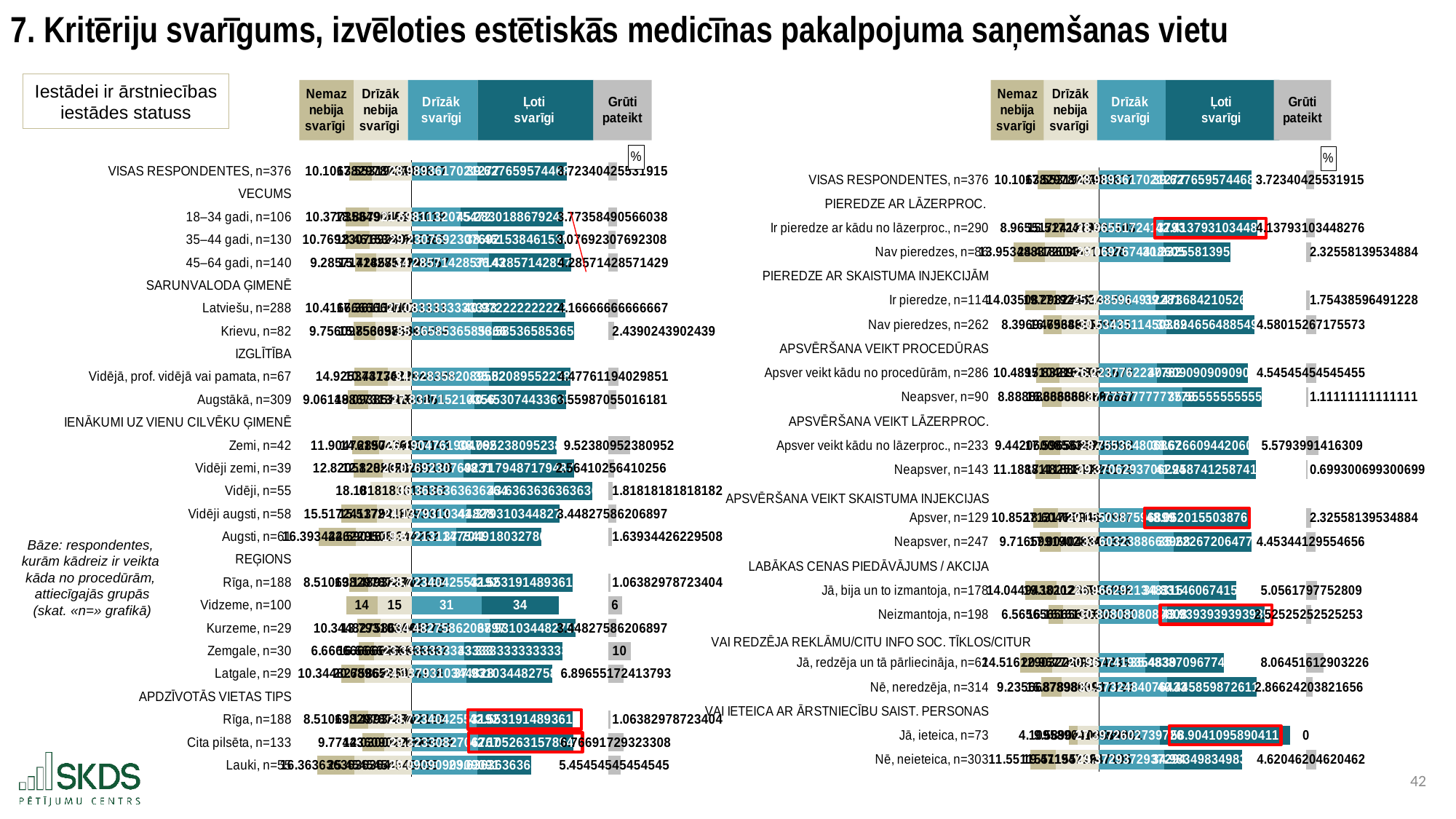
In the right chart, what is the 'Grūti pateikt' value for 'Jā, ieteica, n=73'? 0 In the left chart, what is the total of the stacked bar for Vidzeme, n=100? 100 In the right chart, what is the 'Grūti pateikt' value for 'Jā, redzēja un tā pārliecināja, n=62'? 8.06451612903226 In the left chart, what is the difference between the 'Ļoti svarīgi' and 'Drīzāk svarīgi' values for Vidzeme, n=100? 3 How many series does the legend of the left chart list? 5 In the left chart, what is the 'Nemaz nebija svarīgi' value for Vidzeme, n=100? 14 In the left chart, what is the 'Grūti pateikt' value for Zemgale, n=30? 10 In the left chart, what is the 'Drīzāk svarīgi' value for Vidzeme, n=100? 31 In the left chart, which has the larger 'Grūti pateikt' value: Zemgale, n=30 or Vidzeme, n=100? Zemgale, n=30 What kind of chart is used on this slide? stacked bar chart In the left chart, what is the 'Ļoti svarīgi' value for Vidzeme, n=100? 34 What is the title shown in the box at the top left of the left chart? Iestādei ir ārstniecības iestādes statuss